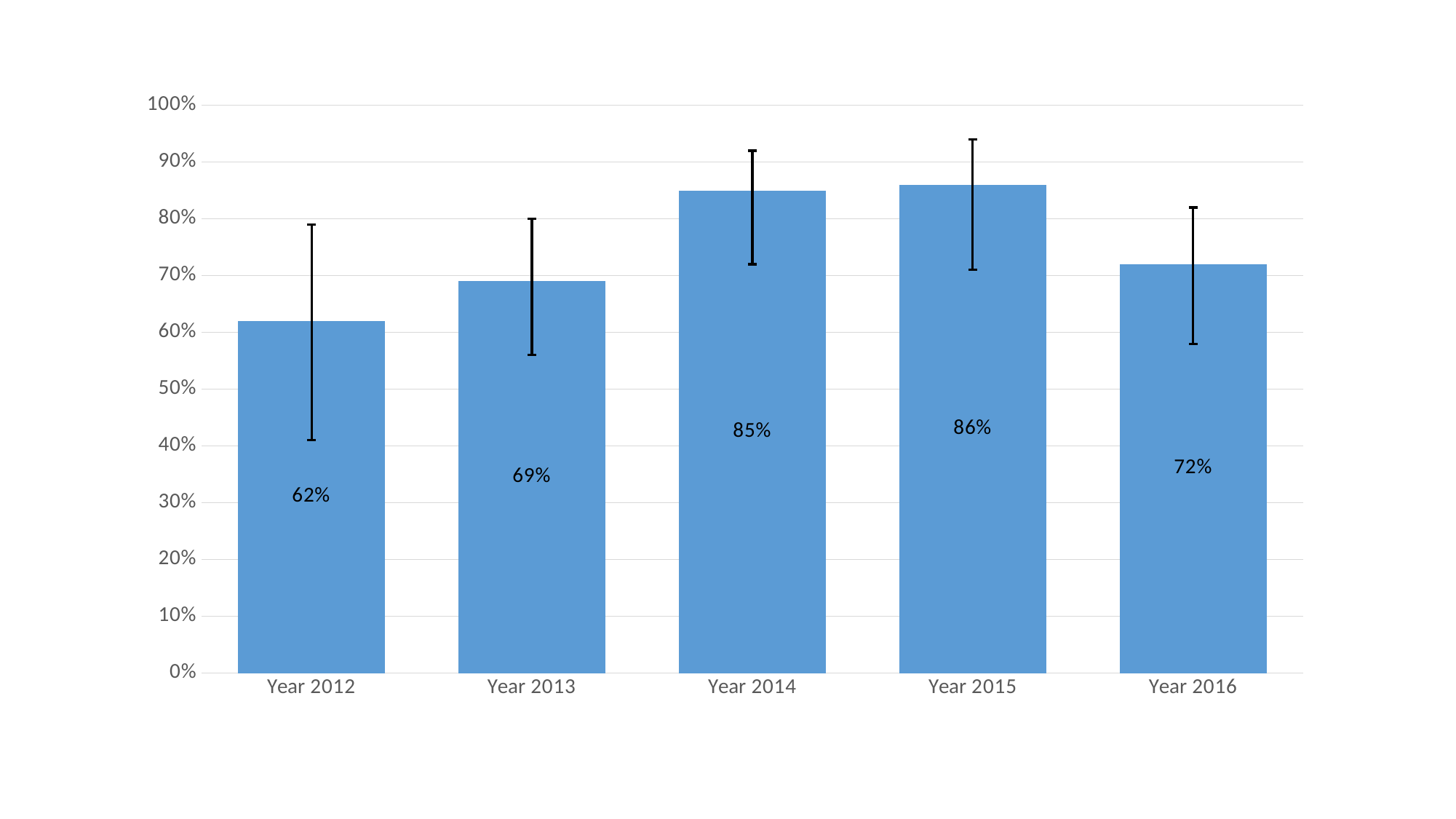
What is the value for Year 2016? 72% Which year has the lowest value? Year 2012 What is the value for Year 2014? 85% Which is larger, the value for Year 2013 or the value for Year 2016? Year 2016 Do the values rise or fall from Year 2012 to Year 2015? Rise What kind of chart is shown on the slide? Bar chart What is the value for Year 2012? 62% Is the value for Year 2013 greater or less than 60%? greater Which year has the highest value? Year 2015 How many years are shown on the x axis? 5 What is the difference between the values for Year 2015 and Year 2016? 14% What is the difference between the values for Year 2014 and Year 2012? 23%